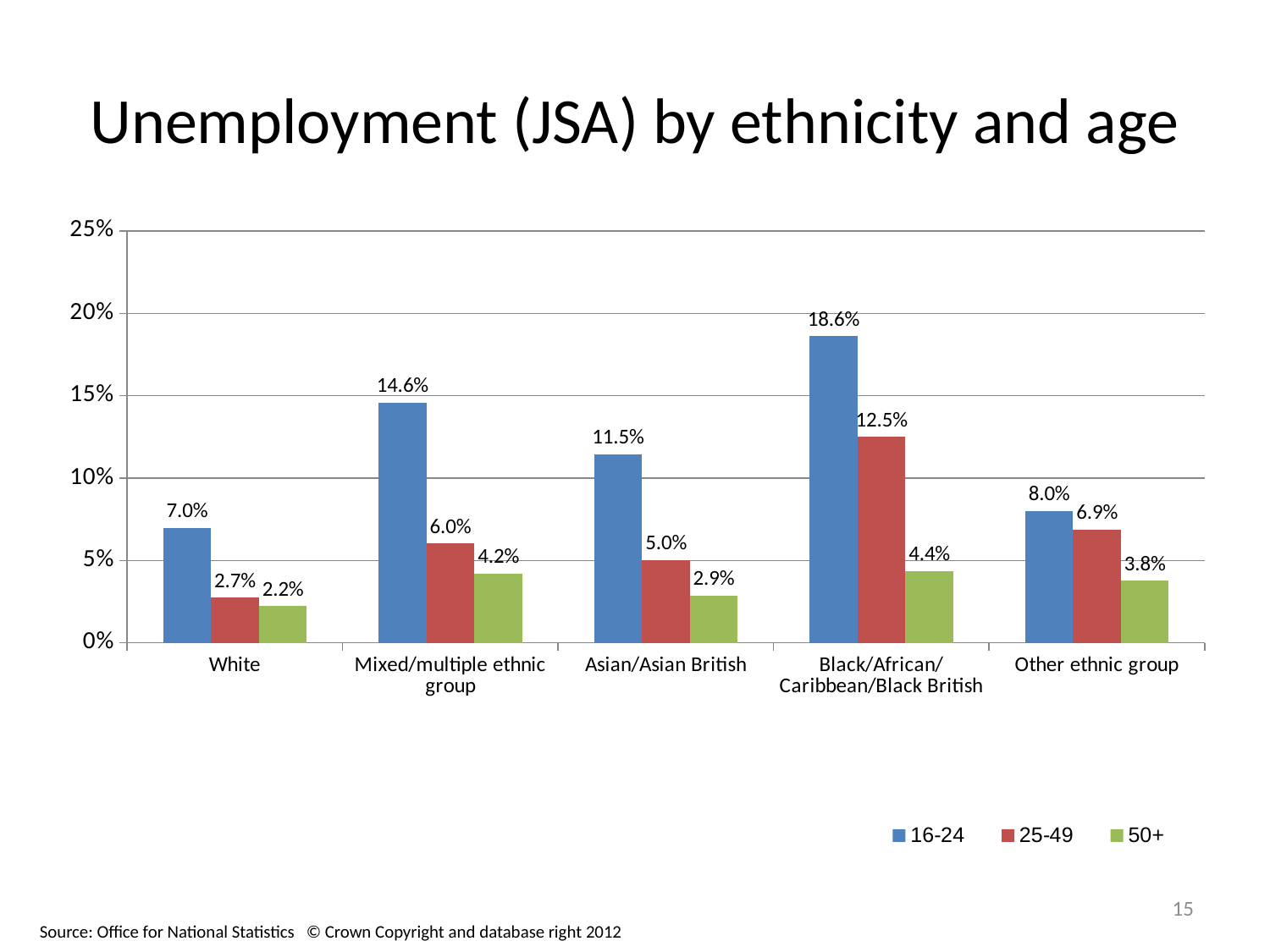
Which is larger: the 25-49 rate for Asian/Asian British or the 25-49 rate for Other ethnic group? Other ethnic group What is the difference between the 16-24 and 25-49 unemployment rates in the Mixed/multiple ethnic group category? 8.6% Which ethnic group has the highest unemployment rate for the 16-24 age group? Black/African/Caribbean/Black British How many ethnic group categories are shown on the x axis? 5 How many age groups does the legend list? 3 What is the unemployment rate for the 50+ age group in the White category? 2.2% What is the unemployment rate for the 25-49 age group in the Other ethnic group category? 6.9% What is the unemployment rate for the 16-24 age group in the Black/African/Caribbean/Black British category? 18.6% Which ethnic group has the lowest unemployment rate for the 50+ age group? White Is the 16-24 unemployment rate for Asian/Asian British greater or less than 10%? greater What type of chart is shown on the slide? Bar chart What is the title of the chart? Unemployment (JSA) by ethnicity and age